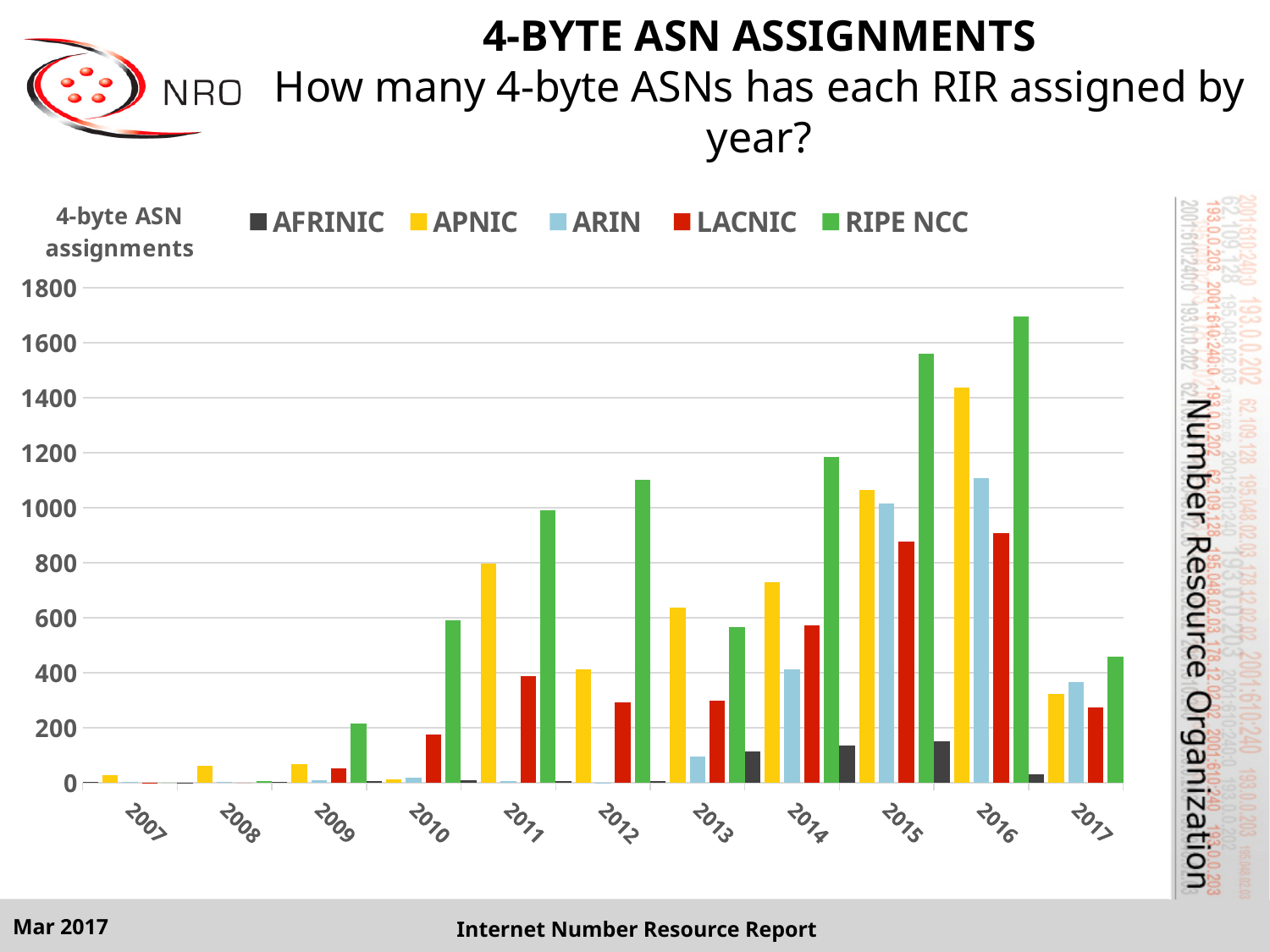
What kind of chart is shown on the slide? bar chart In 2016, which is larger: the value for APNIC or the value for ARIN? APNIC How many years are shown along the x axis? 11 Which RIR has the highest number of 4-byte ASN assignments in 2016? RIPE NCC In which year does RIPE NCC have its highest number of 4-byte ASN assignments? 2016 How many series does the legend list? 5 Which RIR has the lowest number of 4-byte ASN assignments in 2015? AFRINIC Is the value for ARIN in 2016 greater or less than 1000? greater Is the value for LACNIC in 2016 greater or less than 1000? less Is the value for RIPE NCC in 2016 greater or less than 1600? greater Do the values for ARIN rise or fall from 2013 to 2016? rise